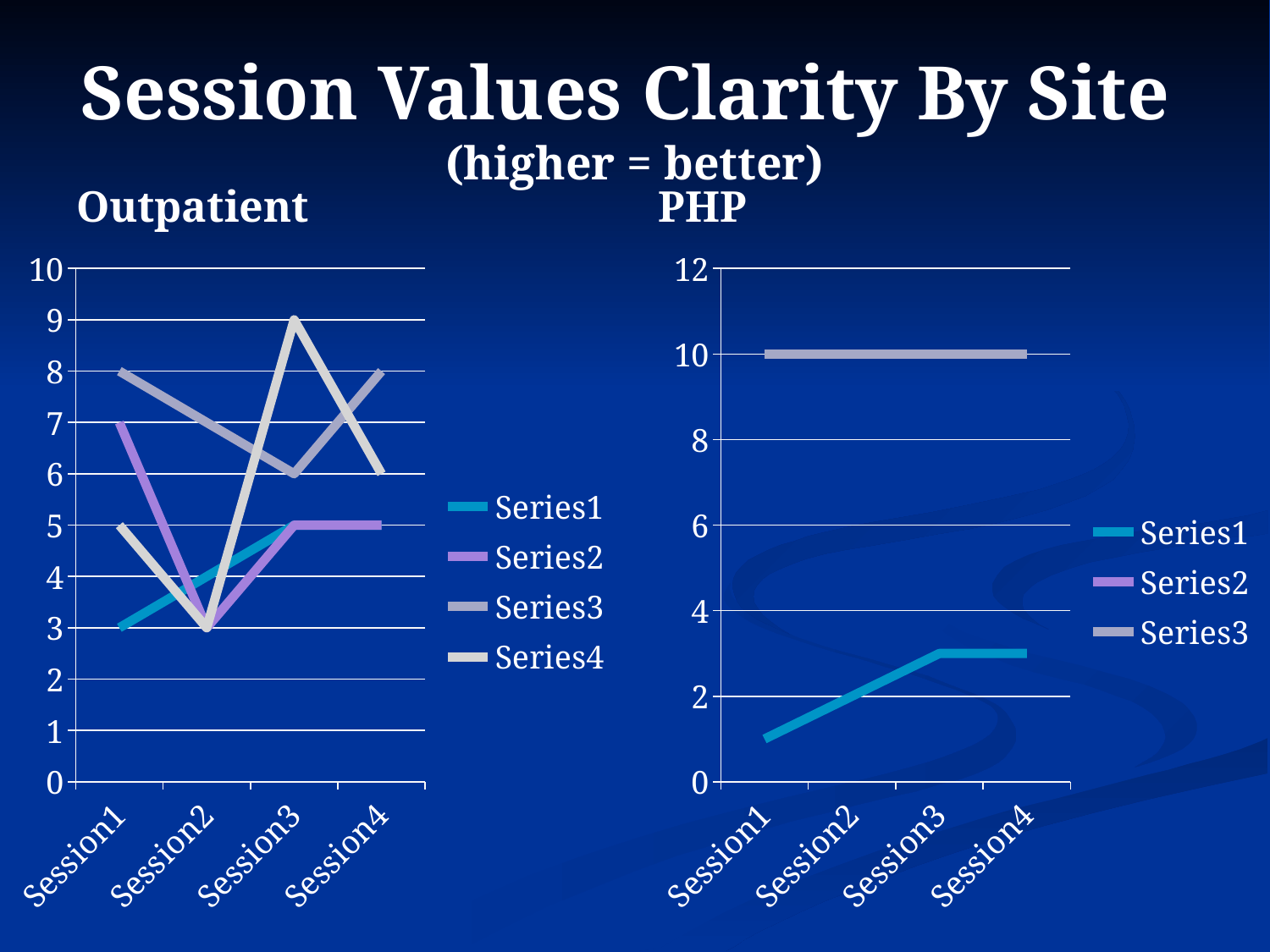
In the Outpatient chart, at which session does Series4 reach its highest value? Session3 What kind of chart is the Outpatient chart? line chart In the PHP chart, is the value of Series1 at Session4 greater or less than 4? less How many sessions are shown on the x axis of the Outpatient chart? 4 In the PHP chart, what is the value of Series3 at Session1? 10 How many series does the legend of the Outpatient chart list? 4 In the Outpatient chart, what is the value of Series3 at Session1? 8 How many series does the legend of the PHP chart list? 3 In the Outpatient chart, what is the value of Series4 at Session3? 9 In the PHP chart, what is the value of Series1 at Session2? 2 In the Outpatient chart, at Session1, which is larger: Series3 or Series1? Series3 In the PHP chart, does Series1 rise or fall from Session1 to Session3? rises